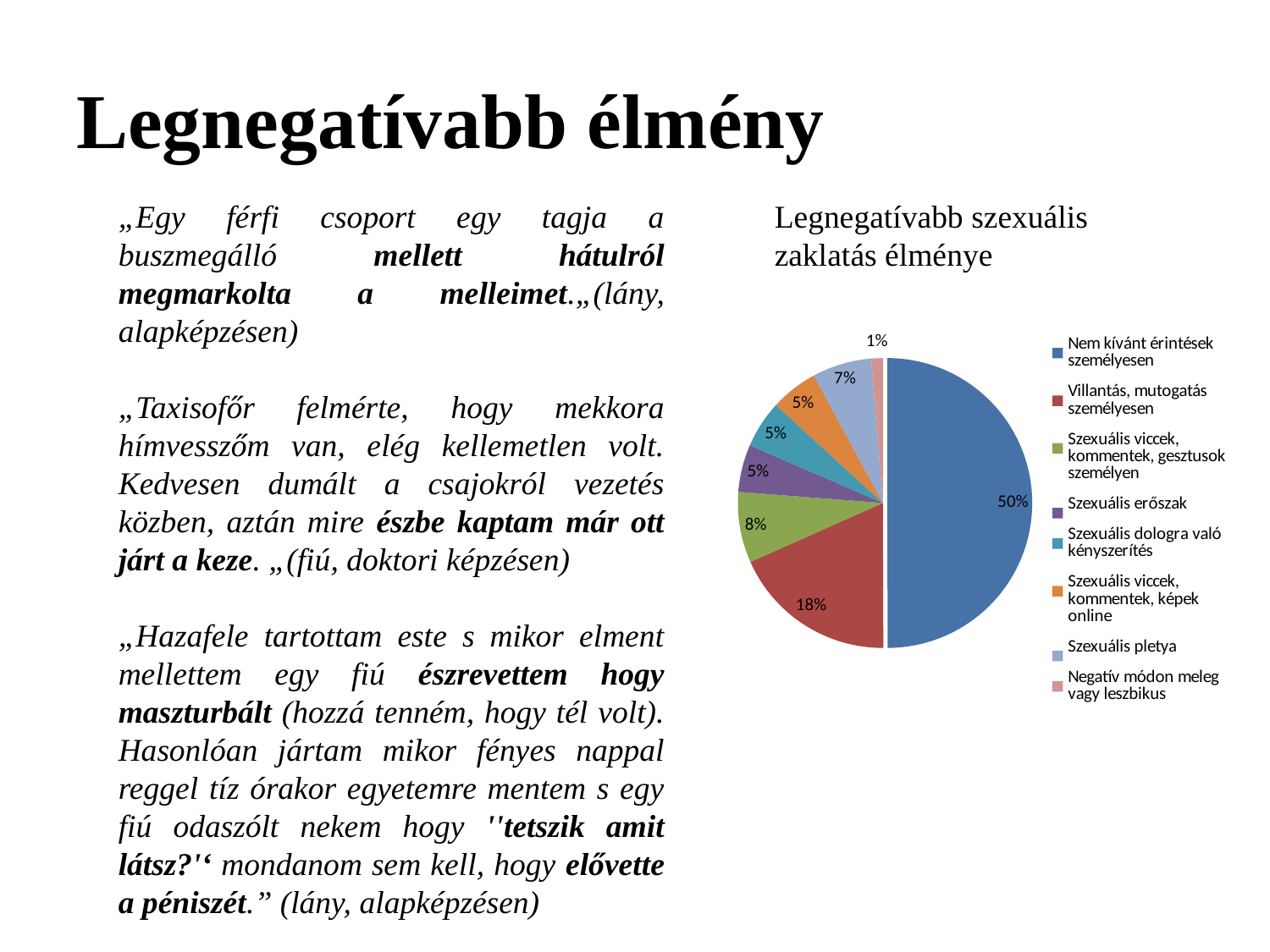
What is the value for 'Szexuális pletya'? 7% Which is larger, the share for 'Szexuális pletya' or the share for 'Szexuális erőszak'? Szexuális pletya What share of the pie is 'Nem kívánt érintések személyesen'? 50% What is the value for 'Villantás, mutogatás személyesen'? 18% What kind of chart is shown on the slide? pie chart What is the value for 'Szexuális viccek, kommentek, gesztusok személyen'? 8% How many slices does the pie chart have? 8 What is the difference between the shares of 'Nem kívánt érintések személyesen' and 'Villantás, mutogatás személyesen'? 32% Which category has the largest share of the pie? Nem kívánt érintések személyesen What is the title of the chart on the slide? Legnegatívabb szexuális zaklatás élménye What is the value for 'Szexuális erőszak'? 5% Which category has the smallest share of the pie? Negatív módon meleg vagy leszbikus